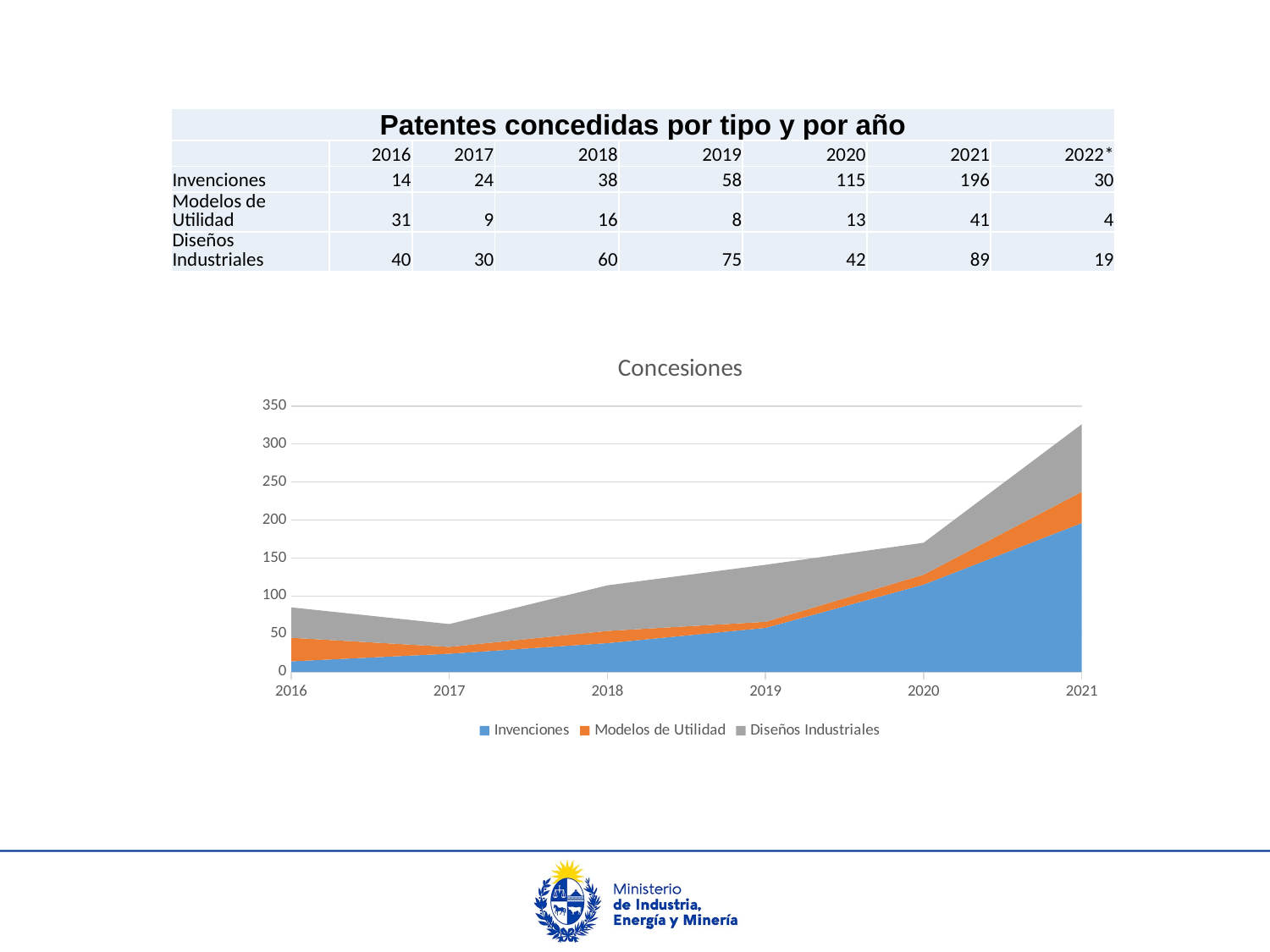
In the 'Concesiones' chart, which year has the lowest total of patents granted? 2017 How many series does the legend of the 'Concesiones' chart list? 3 How many years are shown on the x axis of the 'Concesiones' chart? 6 Which series is shown in grey in the 'Concesiones' chart? Diseños Industriales Which series is shown in blue in the 'Concesiones' chart? Invenciones In the 'Concesiones' chart, which year has the highest total of patents granted? 2021 In the 'Concesiones' chart, is the total stacked value for 2017 greater or less than 100? less What kind of chart is the 'Concesiones' chart? stacked area chart In the 'Concesiones' chart, does the Invenciones series rise or fall from 2017 to 2021? rise According to the slide, what is the total of the stacked values for 2021 in the 'Concesiones' chart (Invenciones, Modelos de Utilidad and Diseños Industriales)? 326 According to the slide, how many Invenciones patents were granted in 2021? 196 In the 'Concesiones' chart, is the total stacked value for 2021 greater or less than 300? greater